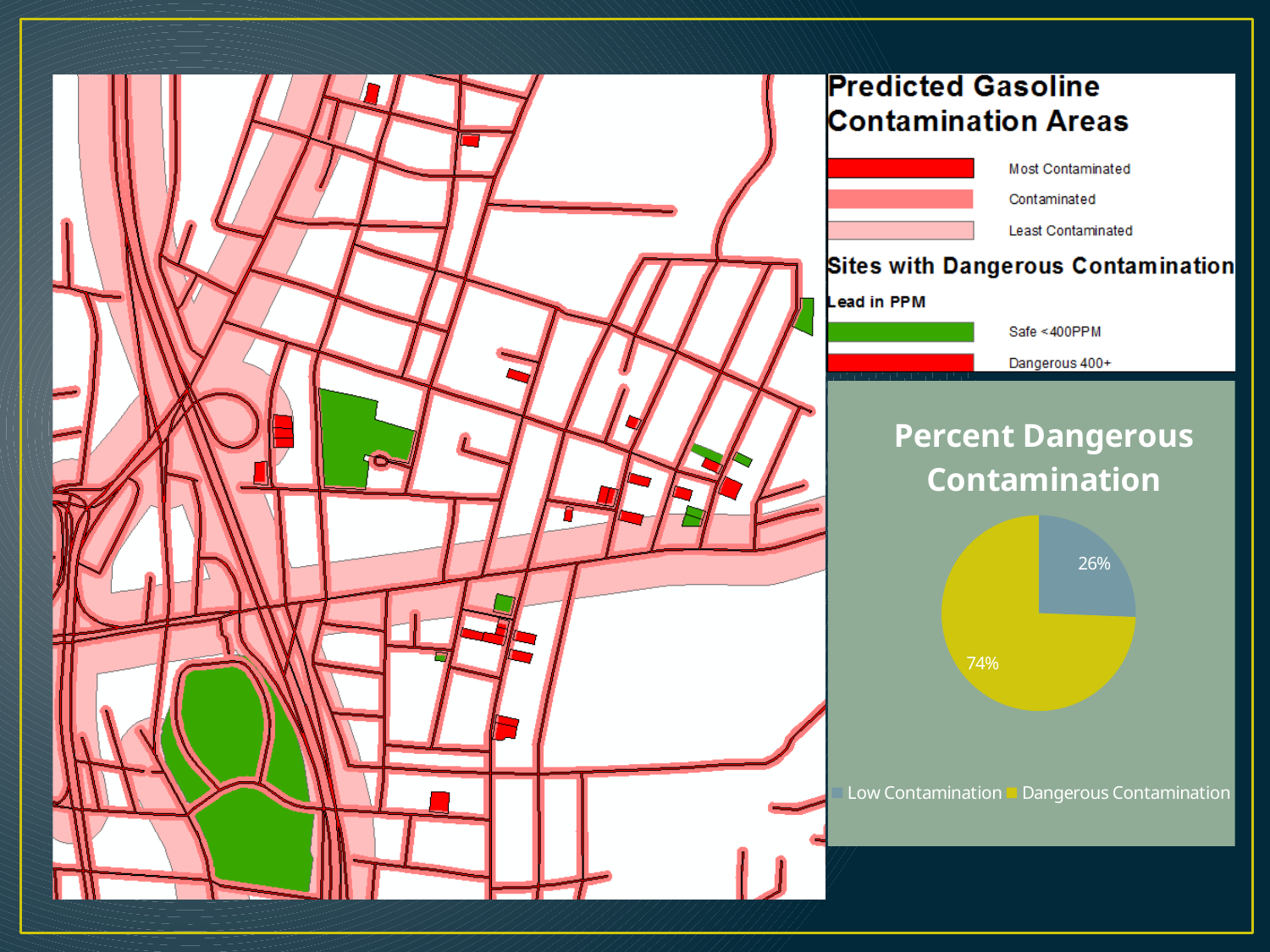
In the 'Percent Dangerous Contamination' pie chart, how many entries does the legend list? 2 What kind of chart is the 'Percent Dangerous Contamination' chart? pie chart In the 'Percent Dangerous Contamination' pie chart, which slice is the smallest? Low Contamination In the 'Percent Dangerous Contamination' pie chart, what share is Dangerous Contamination? 74% In the 'Percent Dangerous Contamination' pie chart, which is larger: Low Contamination or Dangerous Contamination? Dangerous Contamination What is the title of the pie chart on the slide? Percent Dangerous Contamination In the 'Percent Dangerous Contamination' pie chart, what is the difference in percentage points between Dangerous Contamination and Low Contamination? 48 In the 'Percent Dangerous Contamination' pie chart, which slice is the largest? Dangerous Contamination In the 'Percent Dangerous Contamination' pie chart, what colour is the Dangerous Contamination slice? yellow In the 'Percent Dangerous Contamination' pie chart, how many slices are there? 2 In the 'Percent Dangerous Contamination' pie chart, what share is Low Contamination? 26%